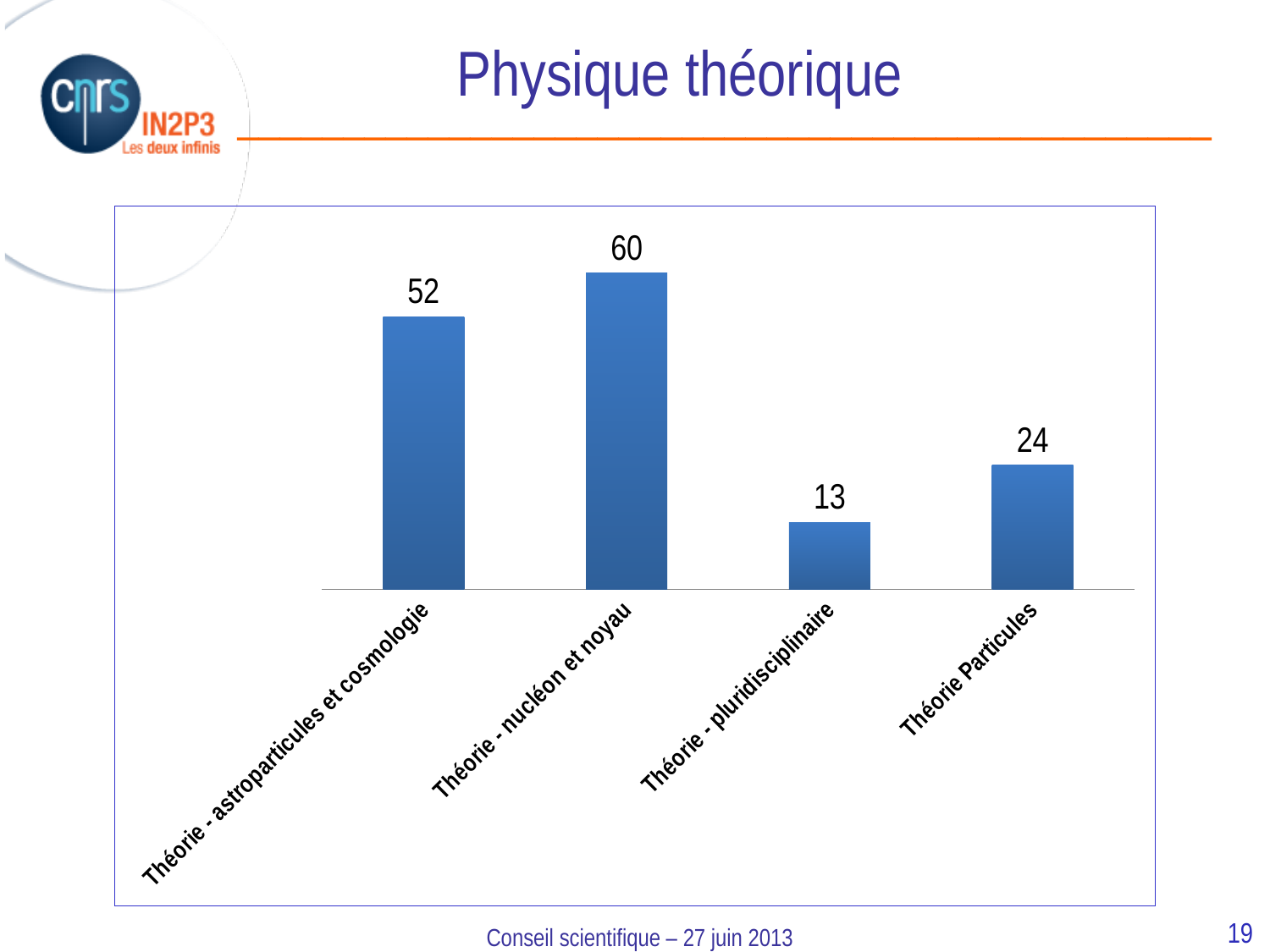
What kind of chart is shown on the slide? Bar chart How many categories are shown in the chart? 4 Which is larger, the value for Théorie Particules or the value for Théorie - pluridisciplinaire? Théorie Particules What is the difference between the values for Théorie - nucléon et noyau and Théorie - astroparticules et cosmologie? 8 What is the title of the slide containing the chart? Physique théorique Which category has the lowest value? Théorie - pluridisciplinaire What is the value for Théorie - pluridisciplinaire? 13 What is the value for Théorie Particules? 24 Which category has the highest value? Théorie - nucléon et noyau What is the value for Théorie - nucléon et noyau? 60 What is the value for Théorie - astroparticules et cosmologie? 52 What is the difference between the values for Théorie Particules and Théorie - pluridisciplinaire? 11